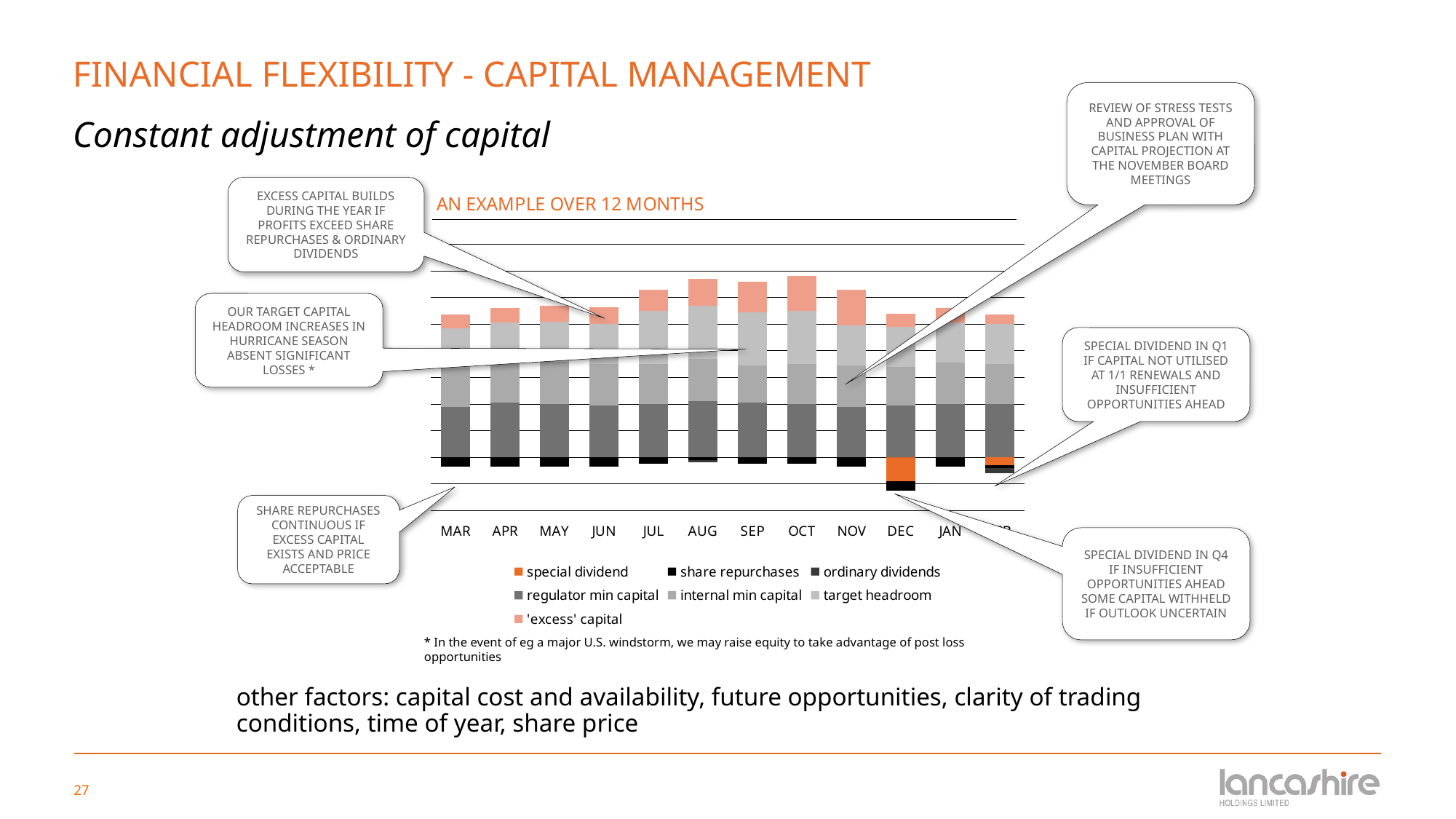
Is the total bar for OCT taller or shorter than the total bar for MAR? Taller What kind of chart is shown on the slide? Stacked bar chart Is the total bar for AUG taller or shorter than the total bar for APR? Taller What is the title shown above the chart? AN EXAMPLE OVER 12 MONTHS In which two months does a 'special dividend' segment appear in the chart? DEC and FEB Which series is listed first in the chart legend? special dividend Which month has the tallest stacked bar in the chart? OCT How many series does the chart legend list? 7 Do the stacked bars generally rise or fall from MAR to OCT? Rise Which colour represents 'special dividend' in the legend? Orange Which month shows the largest 'special dividend' segment? DEC